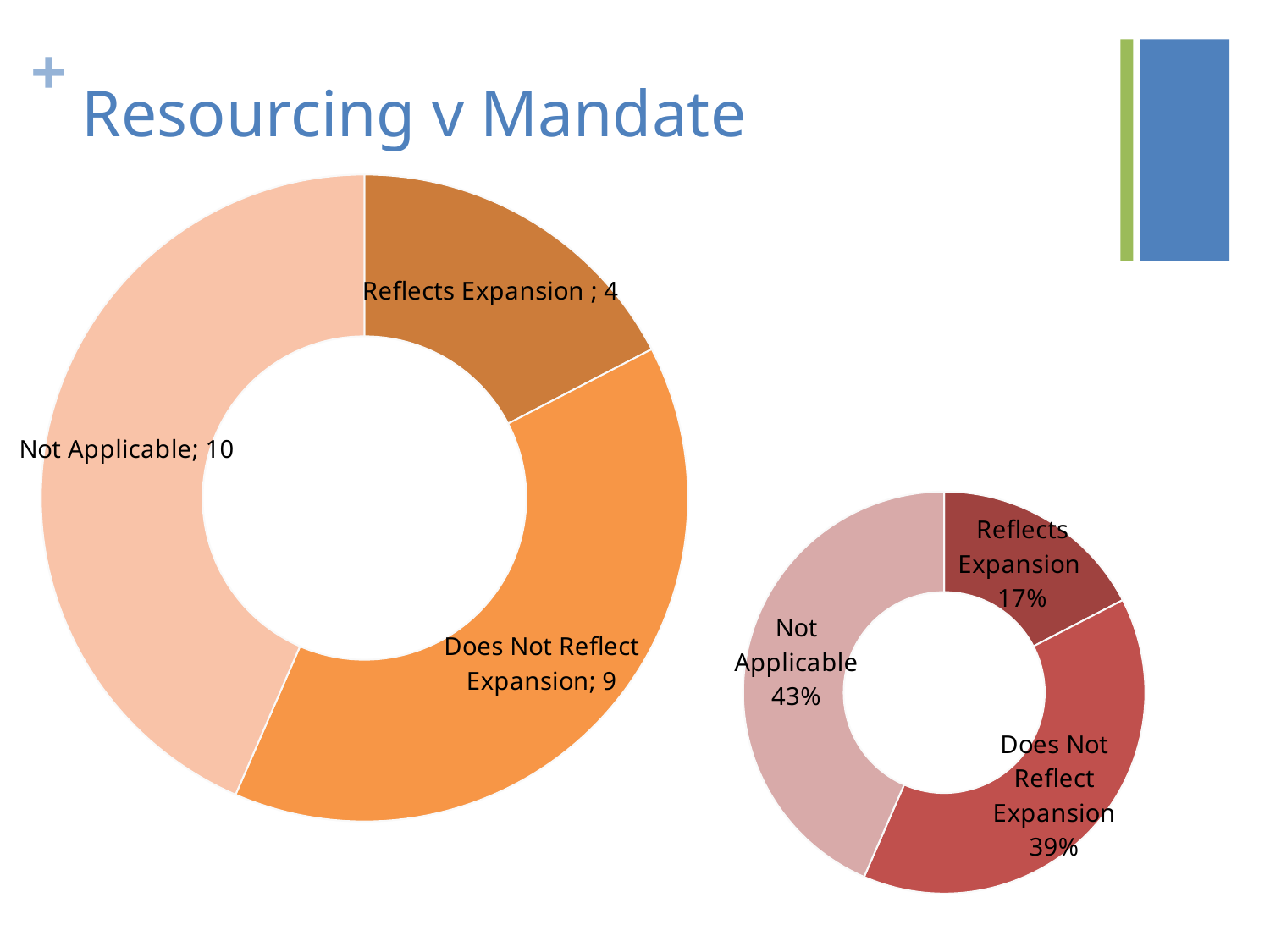
In the left chart, what is the total of all three categories? 23 In the left chart, what is the value for Not Applicable? 10 In the left chart, what is the difference between Not Applicable and Reflects Expansion? 6 How many categories does the left chart show? 3 In the right chart, which is larger: Reflects Expansion or Does Not Reflect Expansion? Does Not Reflect Expansion What kind of chart is the right chart? Doughnut chart In the right chart, which category has the largest share? Not Applicable In the left chart, what is the value for Does Not Reflect Expansion? 9 In the left chart, what is the value for Reflects Expansion? 4 In the right chart, what percentage is shown for Not Applicable? 43% In the right chart, what percentage is shown for Does Not Reflect Expansion? 39% In the left chart, which category has the smallest value? Reflects Expansion